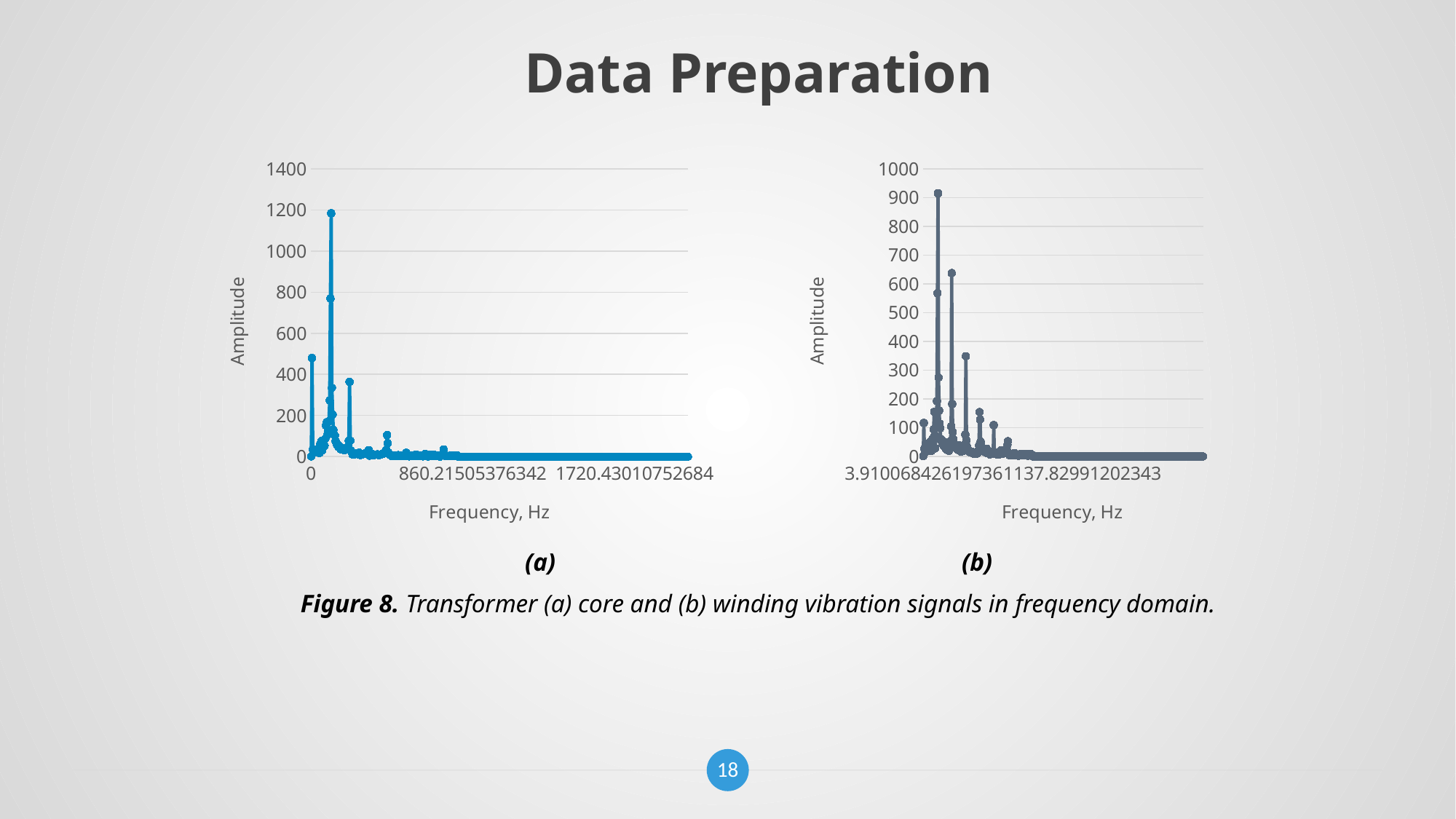
In chart (b), is the highest peak of the signal greater or less than 800? greater Which chart has the higher maximum peak amplitude, chart (a) or chart (b)? chart (a) What kind of chart is chart (a) on the left of the slide? line chart In chart (b), is the second-highest peak greater or less than 700? less In chart (a), is the highest peak of the signal greater or less than 1000? greater What is the label of the x axis in chart (b)? Frequency, Hz How many charts are shown on the slide? 2 In chart (a), do the amplitude values overall rise or fall as frequency increases along the x axis? fall What is the label of the y axis in chart (a)? Amplitude What kind of chart is chart (b) on the right of the slide? line chart